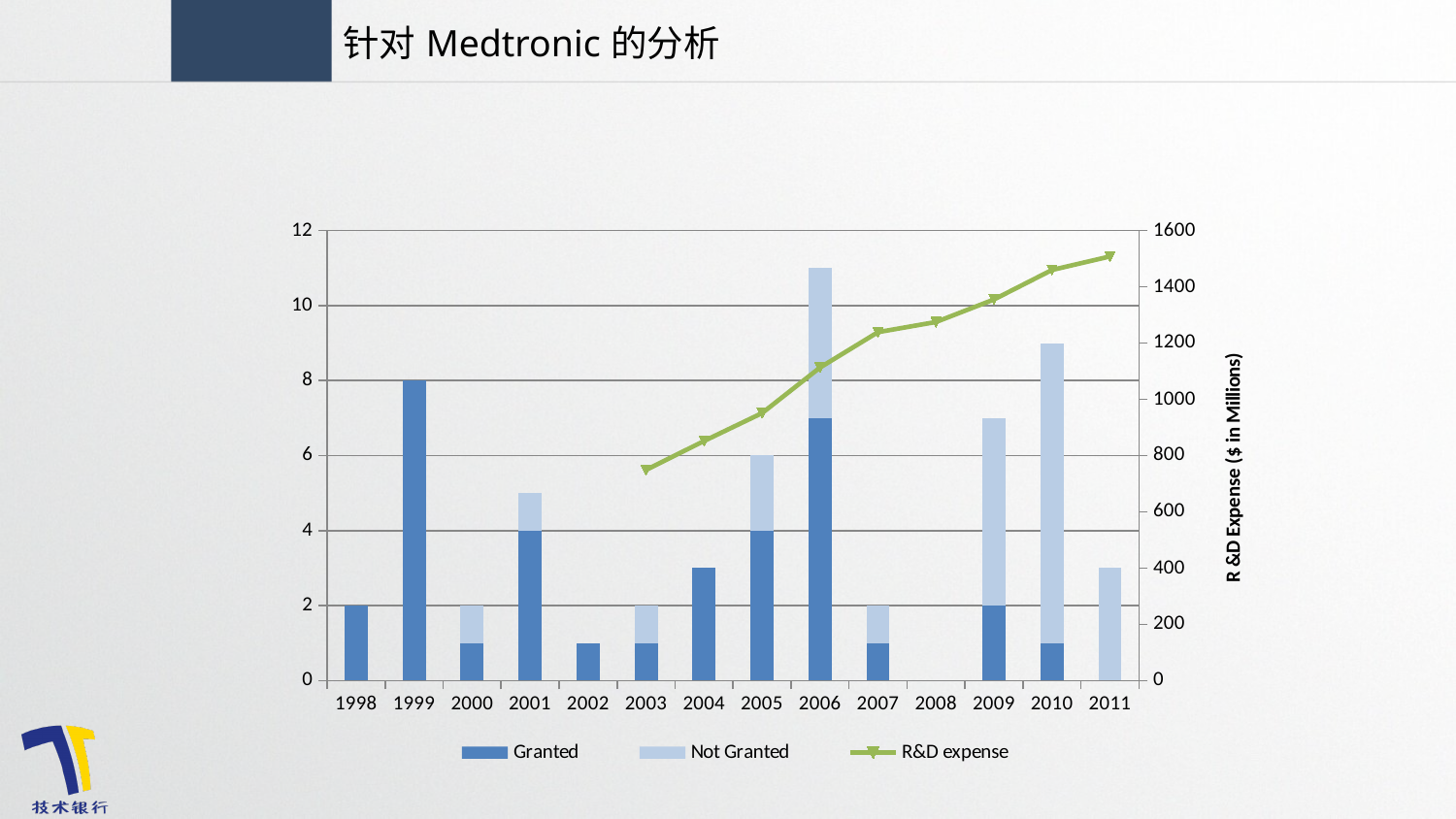
What kind of chart is shown on the slide? A bar chart combined with a line Does the R&D expense line rise or fall from 2003 to 2011? rise Is the R&D expense value for 2011 greater or less than 1400? greater What is the Granted value for 2001? 4 Is the R&D expense value for 2003 greater or less than 800? less How many years are shown on the x axis? 14 What is the total height of the stacked bar for 2005? 6 What is the Granted value for 1998? 2 How many series does the legend list? 3 Which year has the tallest stacked bar overall? 2006 Which year has the highest Granted value? 1999 What is the Granted value for 1999? 8